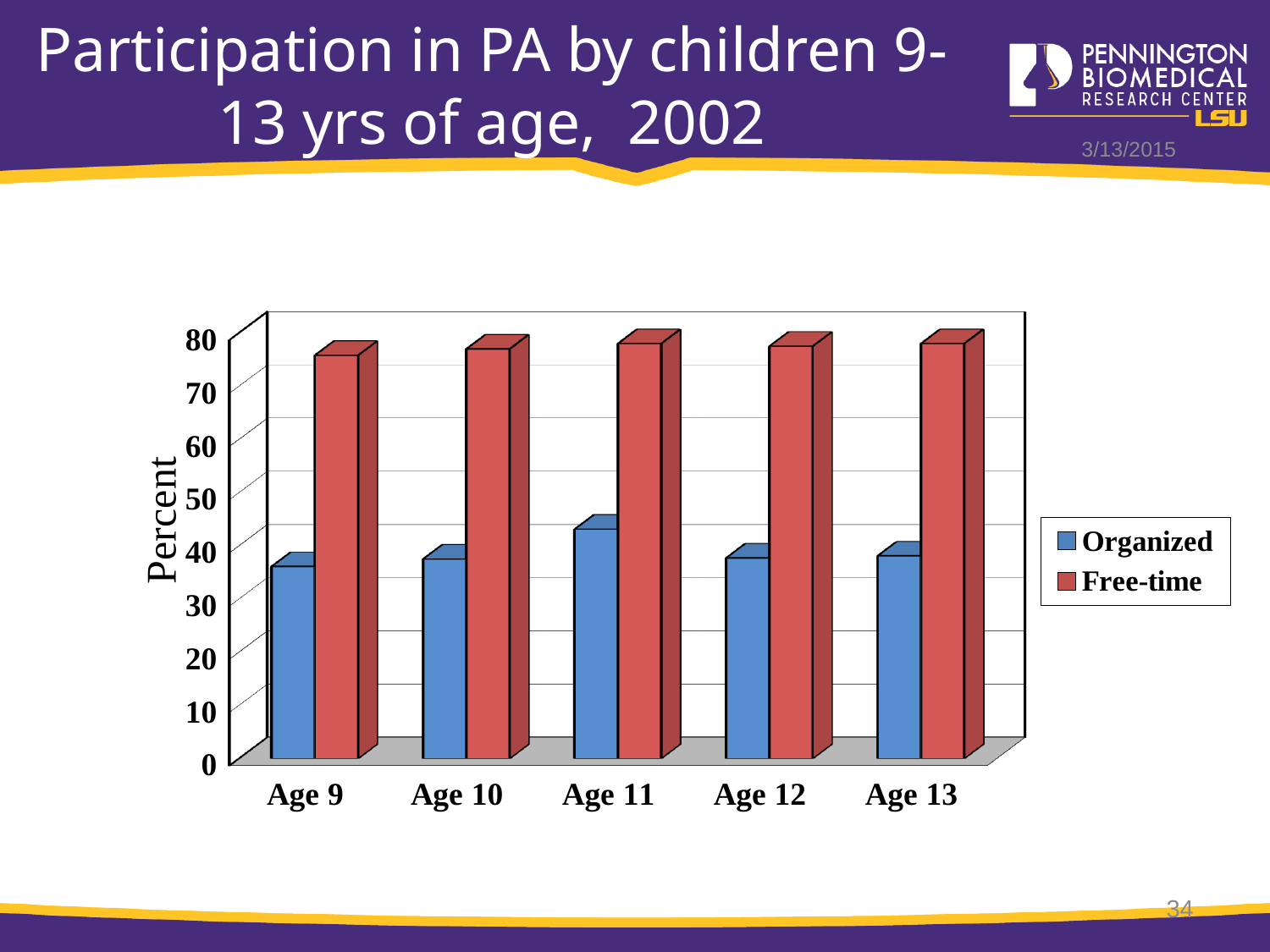
How many age categories are shown on the x axis? 5 What kind of chart is shown on the slide? Bar chart At Age 13, which is larger: Organized or Free-time participation? Free-time What is the label on the y axis? Percent What are the two series named in the legend? Organized and Free-time At Age 9, which is larger: Organized or Free-time participation? Free-time Is the Free-time value for Age 12 greater or less than 80? less Is the Organized value for Age 9 greater or less than 40? less For which age is the Organized participation highest? Age 11 Is the Free-time value for Age 10 greater or less than 70? greater How many series does the legend list? 2